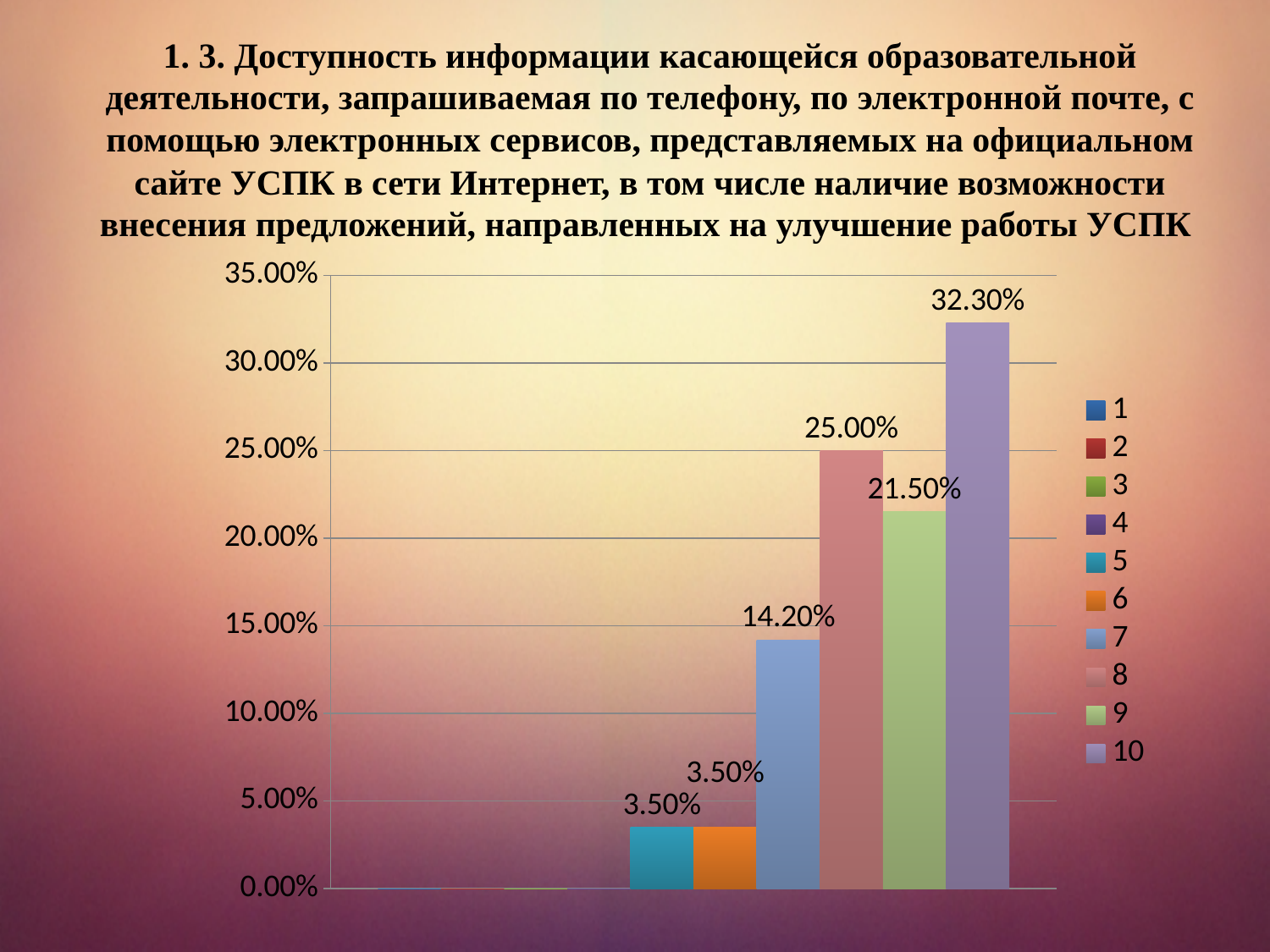
What value is shown for series 7? 14.20% Which series has the highest value? 10 How many series does the legend list? 10 What is the difference between the values for series 8 and series 9? 3.50% What value is shown for series 5? 3.50% What is the difference between the values for series 10 and series 8? 7.30% What value is shown for series 8? 25.00% Which is larger, the value for series 8 or the value for series 9? series 8 What value is shown for series 9? 21.50% What value is shown for series 10? 32.30% What kind of chart is shown on the slide? bar chart Is the value for series 7 greater or less than 10.00%? greater